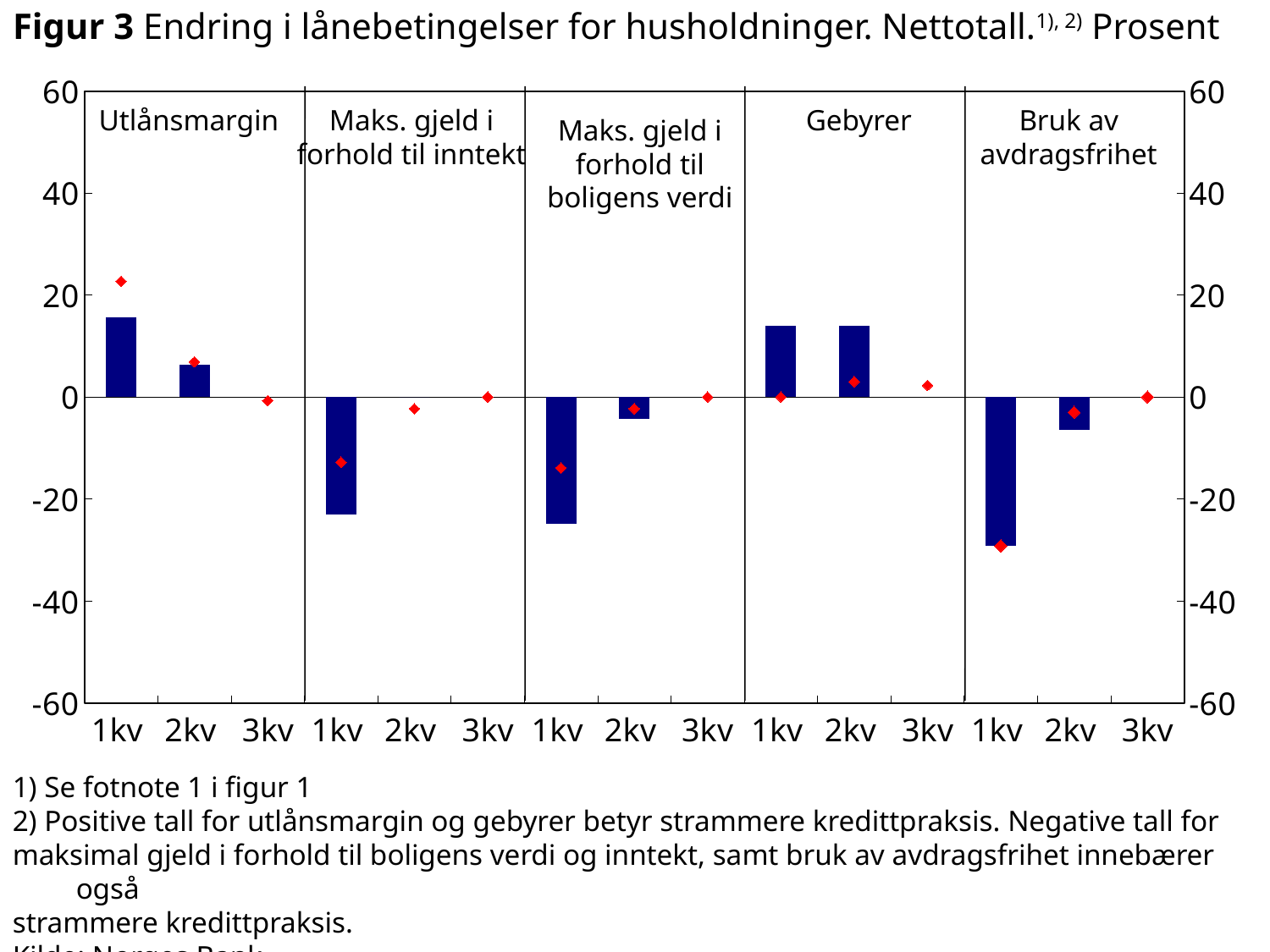
Which panel has the lowest (most negative) bar for 1kv? Bruk av avdragsfrihet What is the maximum value shown on the vertical axis of Figur 3? 60 In the Utlånsmargin panel, which bar is larger, 1kv or 2kv? 1kv Is the bar value for 1kv in the Bruk av avdragsfrihet panel greater or less than -20? less Is the bar value for 1kv in the Utlånsmargin panel greater or less than 0? greater In the Bruk av avdragsfrihet panel, do the bar values rise or fall from 1kv to 3kv? rise How many quarters are shown within each panel of Figur 3? 3 Is the bar value for 1kv in the Gebyrer panel greater or less than 20? less Which panel has the highest bar for 1kv? Utlånsmargin How many lending-condition panels (categories) are shown in Figur 3? 5 What kind of chart is shown in Figur 3? bar chart